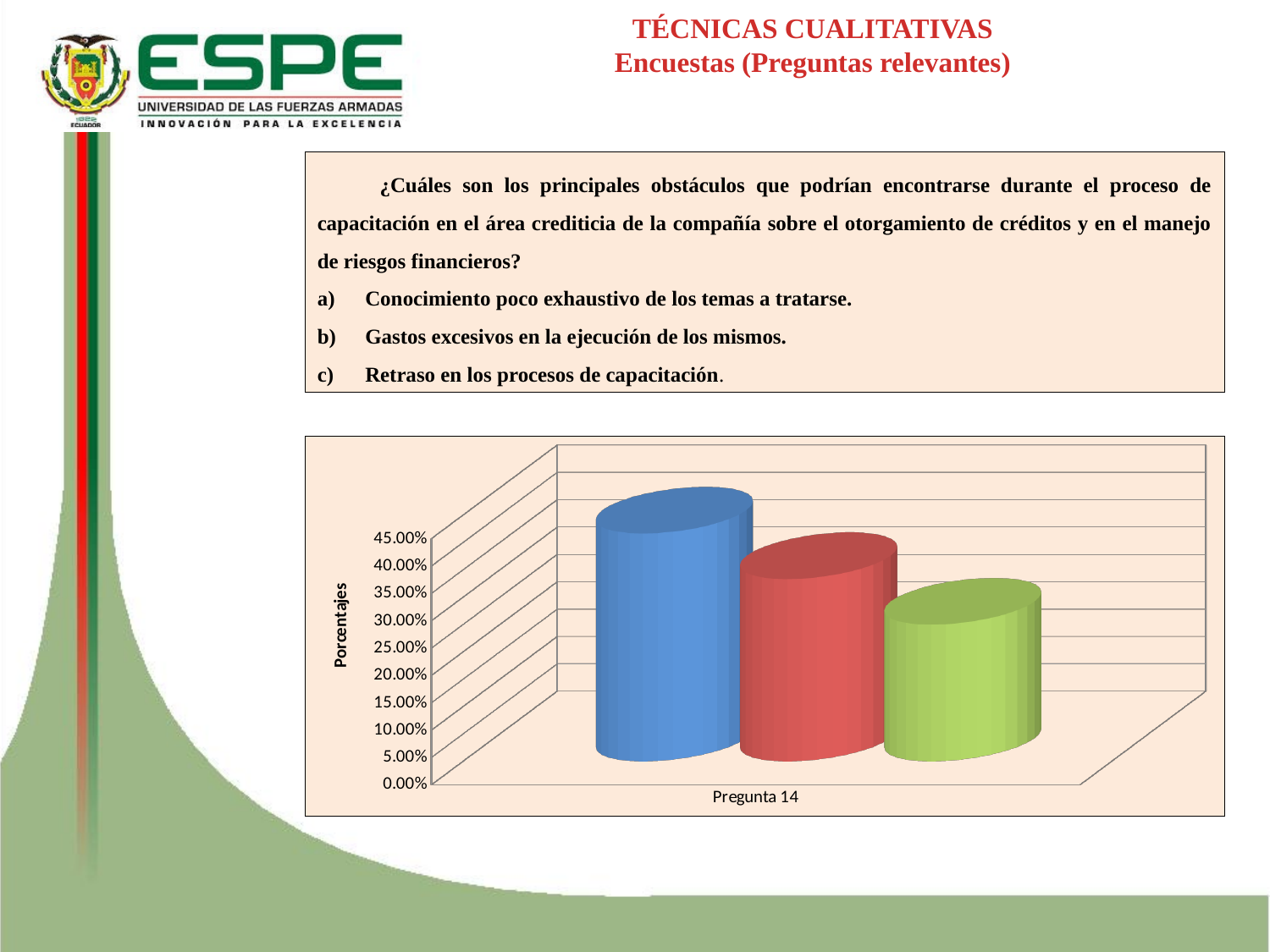
Is the value of the green bar greater or less than 35.00%? less What kind of chart is shown on the slide? bar chart Which is larger, the blue bar or the green bar? the blue bar Which bar is the tallest in the chart? the blue bar What category label appears on the horizontal axis of the chart? Pregunta 14 Do the bar heights rise or fall from left to right across the chart? fall Is the value of the red bar greater or less than 20.00%? greater Which is larger, the red bar or the green bar? the red bar Which bar is the shortest in the chart? the green bar Is the value of the blue bar greater or less than 30.00%? greater What is the title of the vertical axis of the chart? Porcentajes How many bars are plotted in the chart? 3